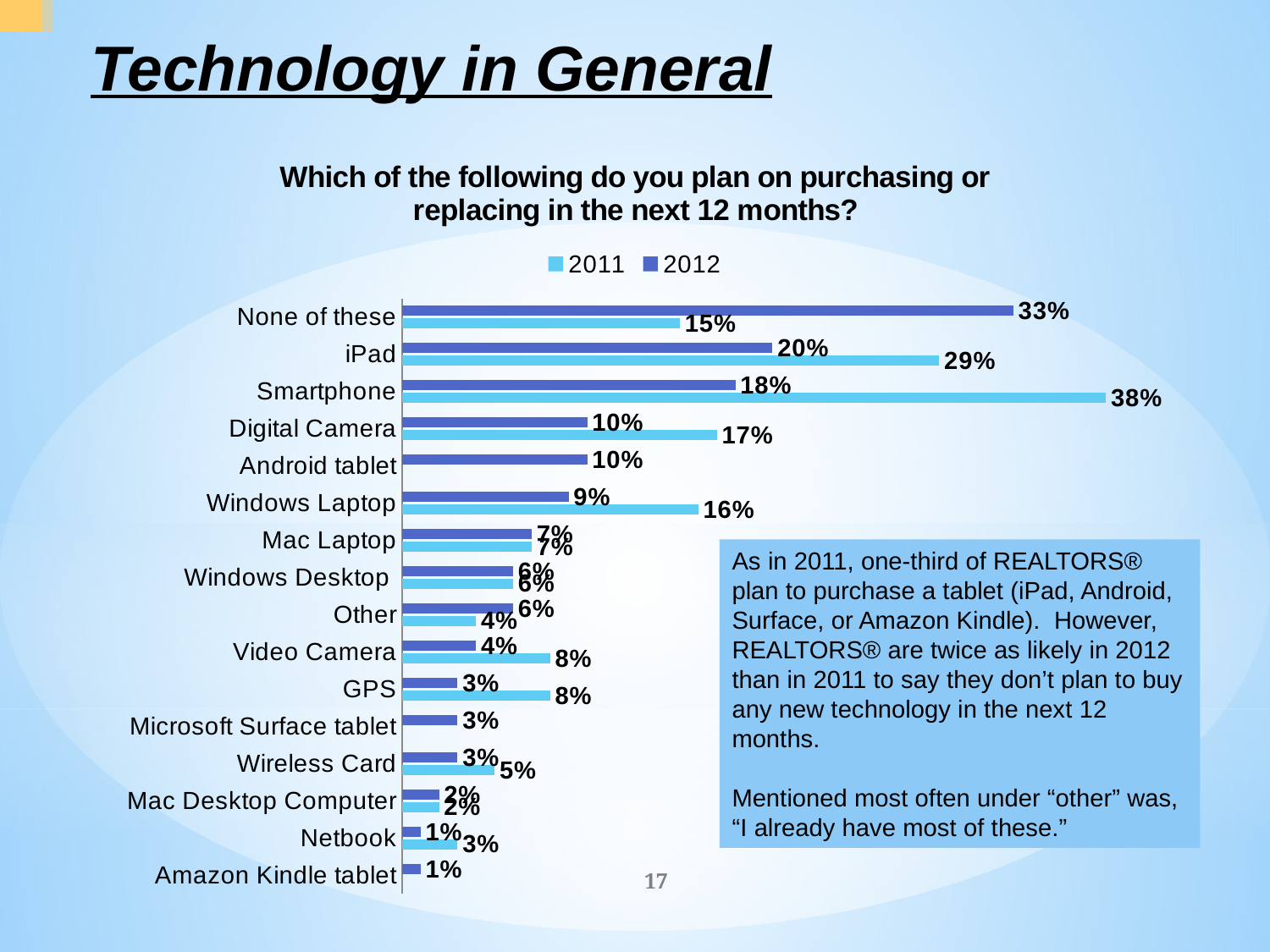
Which category has the highest 2012 value? None of these What is the 2012 value for Android tablet? 10% How many categories are shown on the chart? 16 Which is larger for Digital Camera, the 2011 value or the 2012 value? 2011 What percentage of respondents planned to purchase a Smartphone in 2011? 38% How many series does the legend list? 2 What is the difference between the 2011 and 2012 values for iPad? 9% Which is larger for "Other", the 2011 value or the 2012 value? 2012 Which category has the highest 2011 value? Smartphone What is the 2012 value for "None of these"? 33% What is the difference between the 2012 and 2011 values for "None of these"? 18% What type of chart is shown on the slide? Bar chart